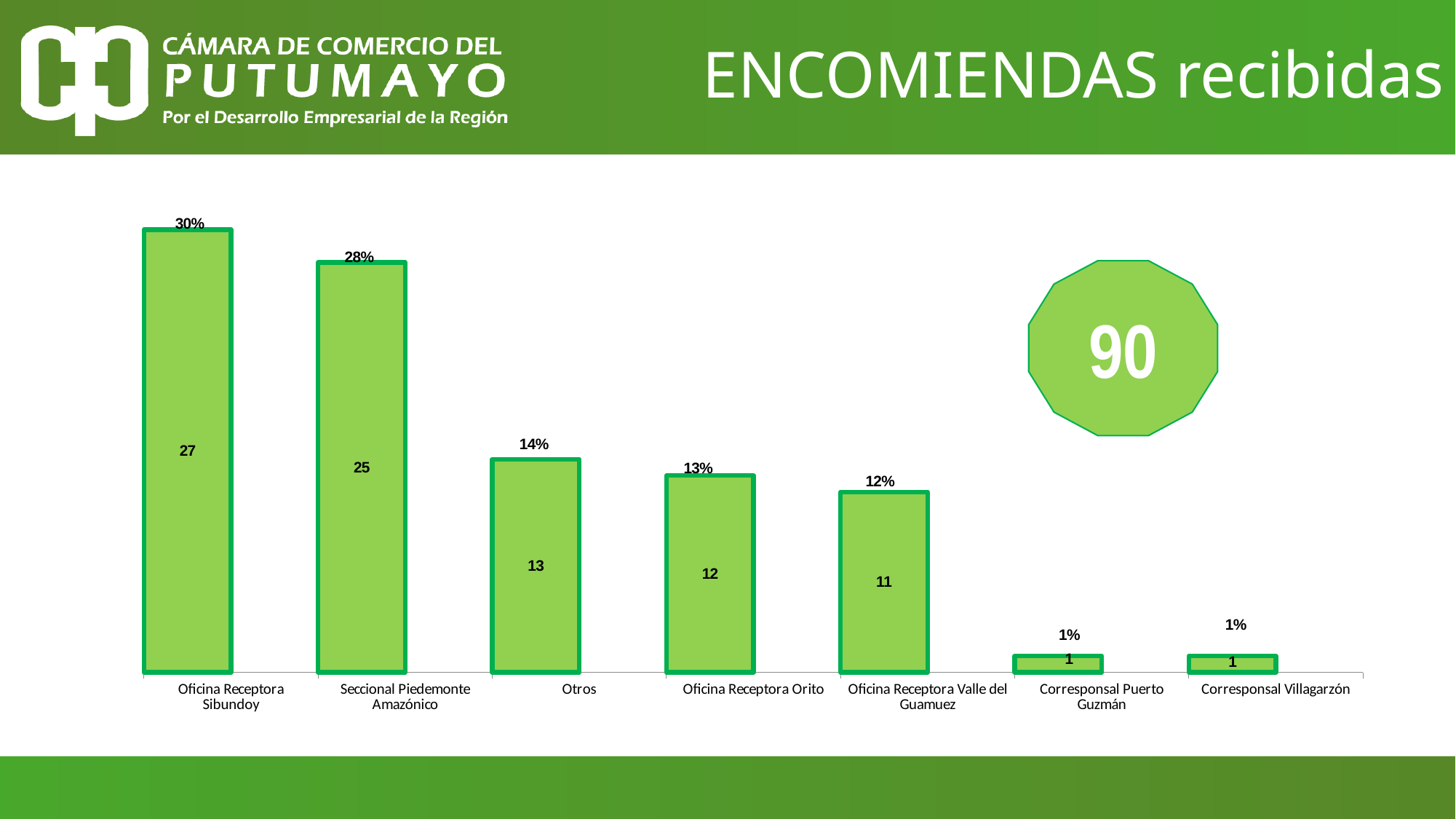
What percentage is shown for Oficina Receptora Valle del Guamuez? 12% Which category has the highest value? Oficina Receptora Sibundoy How many categories are shown on the x axis? 7 What percentage is shown above the bar for Seccional Piedemonte Amazónico? 28% What number is shown in the large green shape to the right of the chart? 90 What is the value for Oficina Receptora Sibundoy? 27 What is the value for Otros? 13 What is the value for Corresponsal Villagarzón? 1 Which is larger, the value for Oficina Receptora Orito or the value for Oficina Receptora Valle del Guamuez? Oficina Receptora Orito What is the difference between the values for Oficina Receptora Sibundoy and Seccional Piedemonte Amazónico? 2 What kind of chart is shown on the slide? bar chart Do the values rise or fall from left to right along the x axis? fall